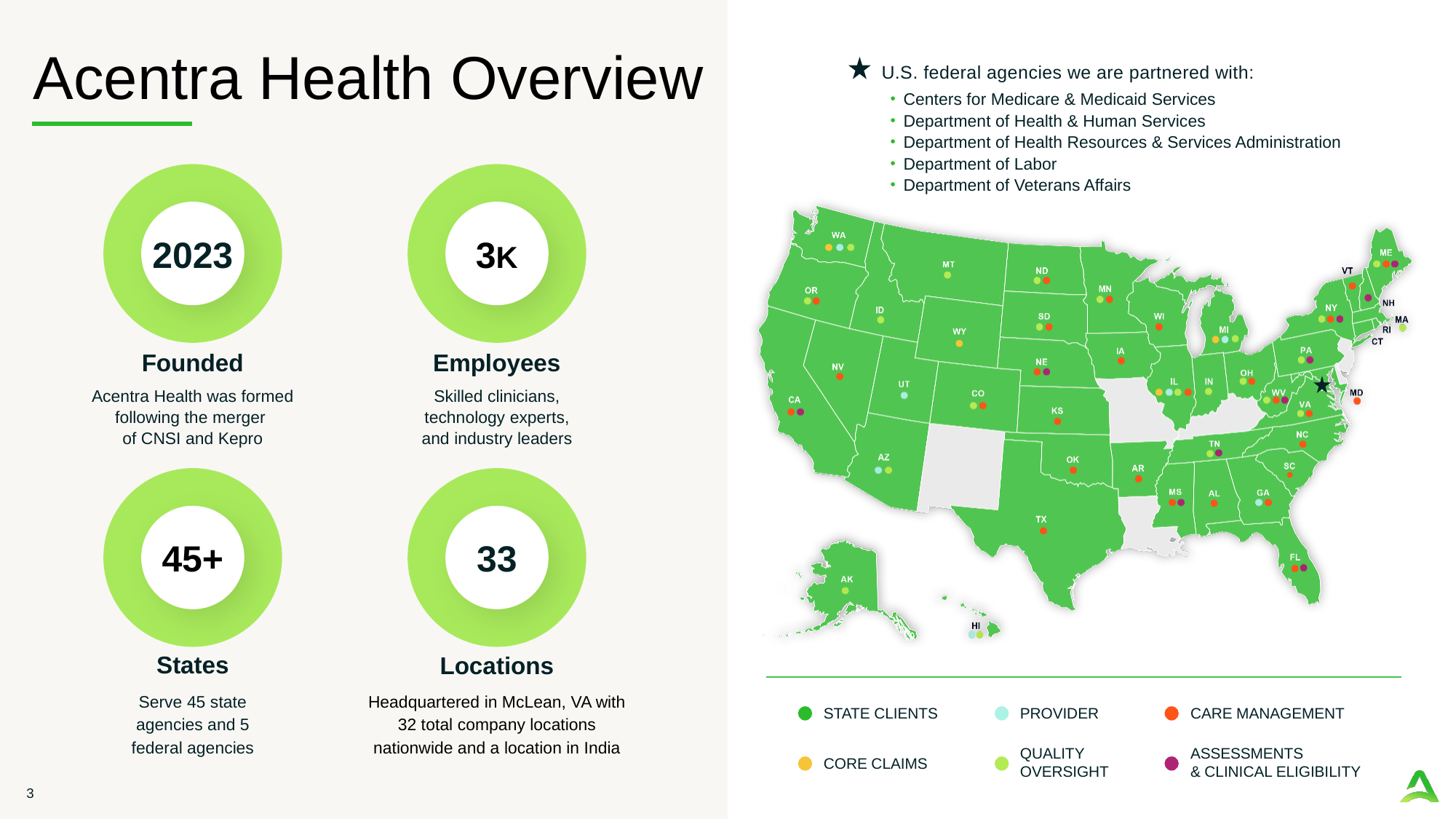
According to the Locations text, how many total company locations are there nationwide? 32 How many circular statistic graphics are on the left side of the slide? 4 In the Employees circle, what value is shown? 3K Which legend category on the map is shown in purple? Assessments & Clinical Eligibility In the Founded circle, what year is shown? 2023 According to the States text, how many state agencies does Acentra Health serve? 45 Which legend category on the map is shown in orange? Care Management How many categories does the map legend list? 6 How many U.S. federal agencies are listed as partners above the map? 5 In the States circle, what value is shown? 45+ What kind of chart is shown on the right side of the slide? map In the Locations circle, what value is shown? 33